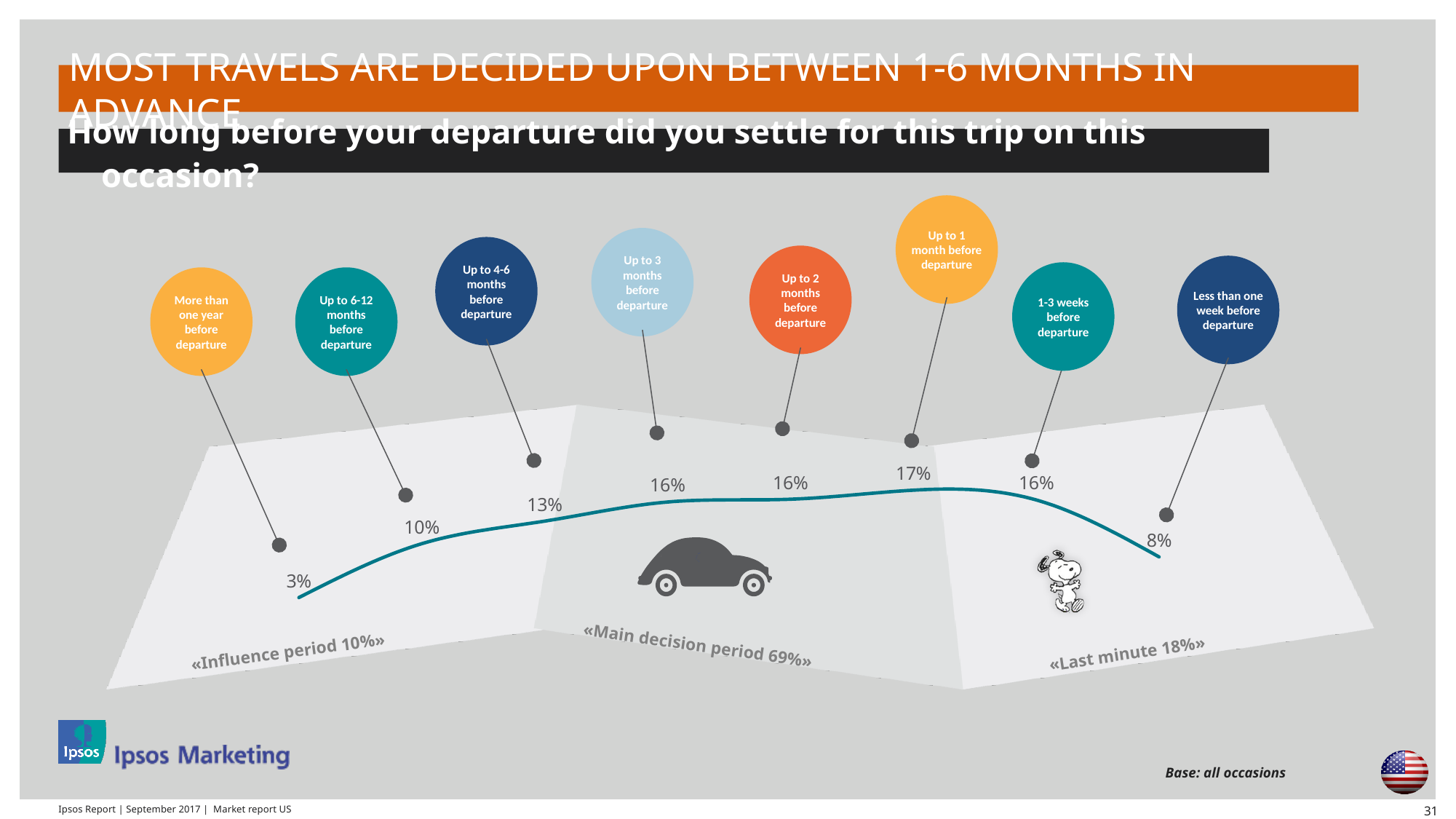
Which is larger: the value for 'Up to 4-6 months before departure' or 'Up to 6-12 months before departure'? Up to 4-6 months before departure Which category has the lowest value? More than one year before departure What share is labelled for the 'Main decision period' on the chart? 69% Which category has the highest value? Up to 1 month before departure What percentage of trips were settled more than one year before departure? 3% What kind of chart is shown on the slide? Line chart What is the value for 'Up to 4-6 months before departure'? 13% How many categories are plotted on the chart? 8 What is the value for 'Less than one week before departure'? 8% What is the value for 'Up to 6-12 months before departure'? 10% What is the value for 'Up to 1 month before departure'? 17% What is the difference between the values for 'Up to 1 month before departure' and 'Less than one week before departure'? 9%